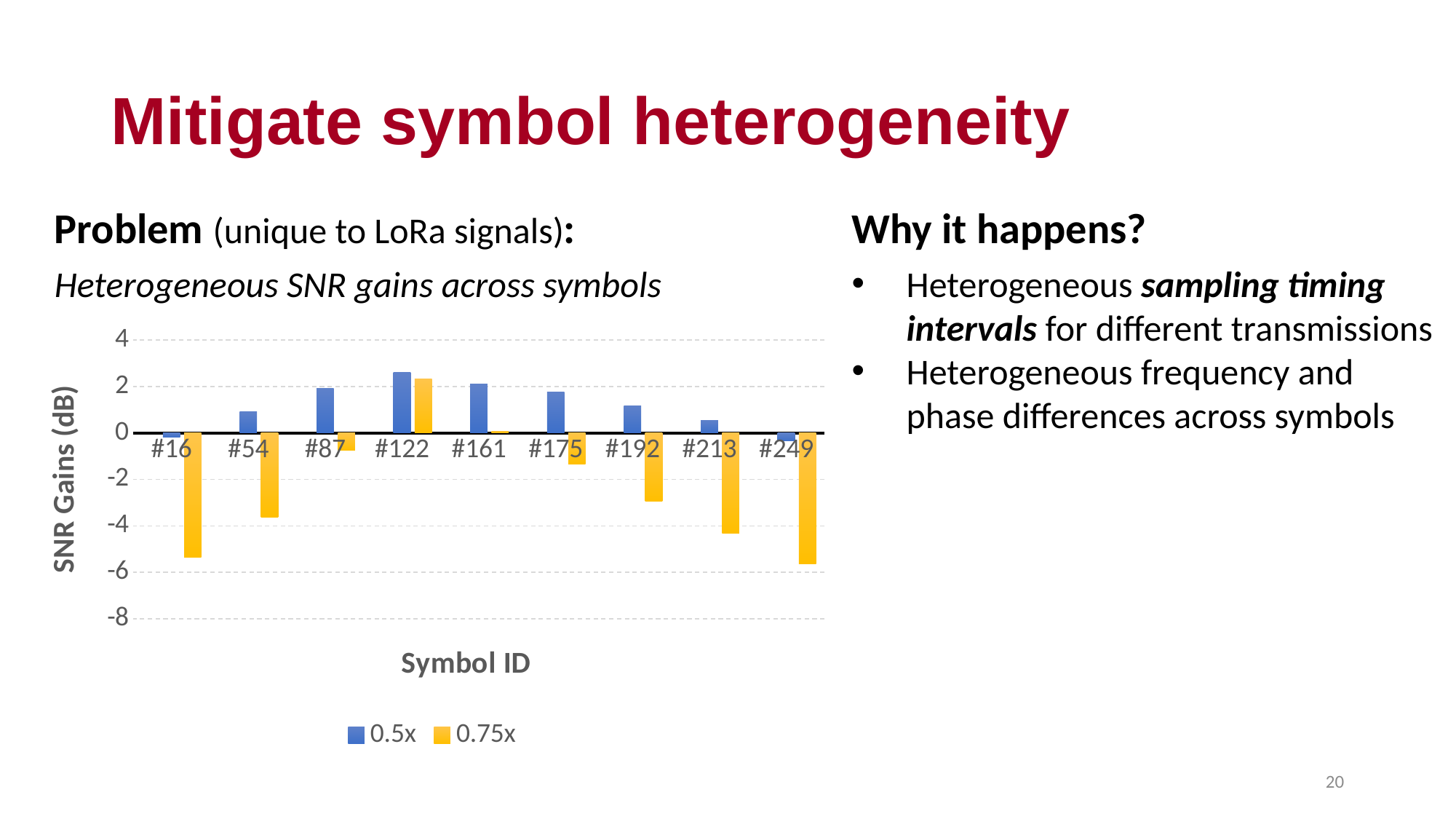
For symbol #87, which series has the larger SNR gain, 0.5x or 0.75x? 0.5x Is the 0.75x SNR gain for symbol #16 greater or less than -4 dB? less How many symbol IDs are shown on the x axis of the chart? 9 Is the 0.75x SNR gain for symbol #192 greater or less than -2 dB? less Which symbol ID has the highest SNR gain for the 0.5x series? #122 Is the 0.5x SNR gain for symbol #54 greater or less than 0 dB? greater Which symbol ID has the highest SNR gain for the 0.75x series? #122 What is the label of the y axis of the chart? SNR Gains (dB) Which colour represents the 0.75x series in the chart? yellow How many series does the chart legend list? 2 What kind of chart is shown on the slide? bar chart